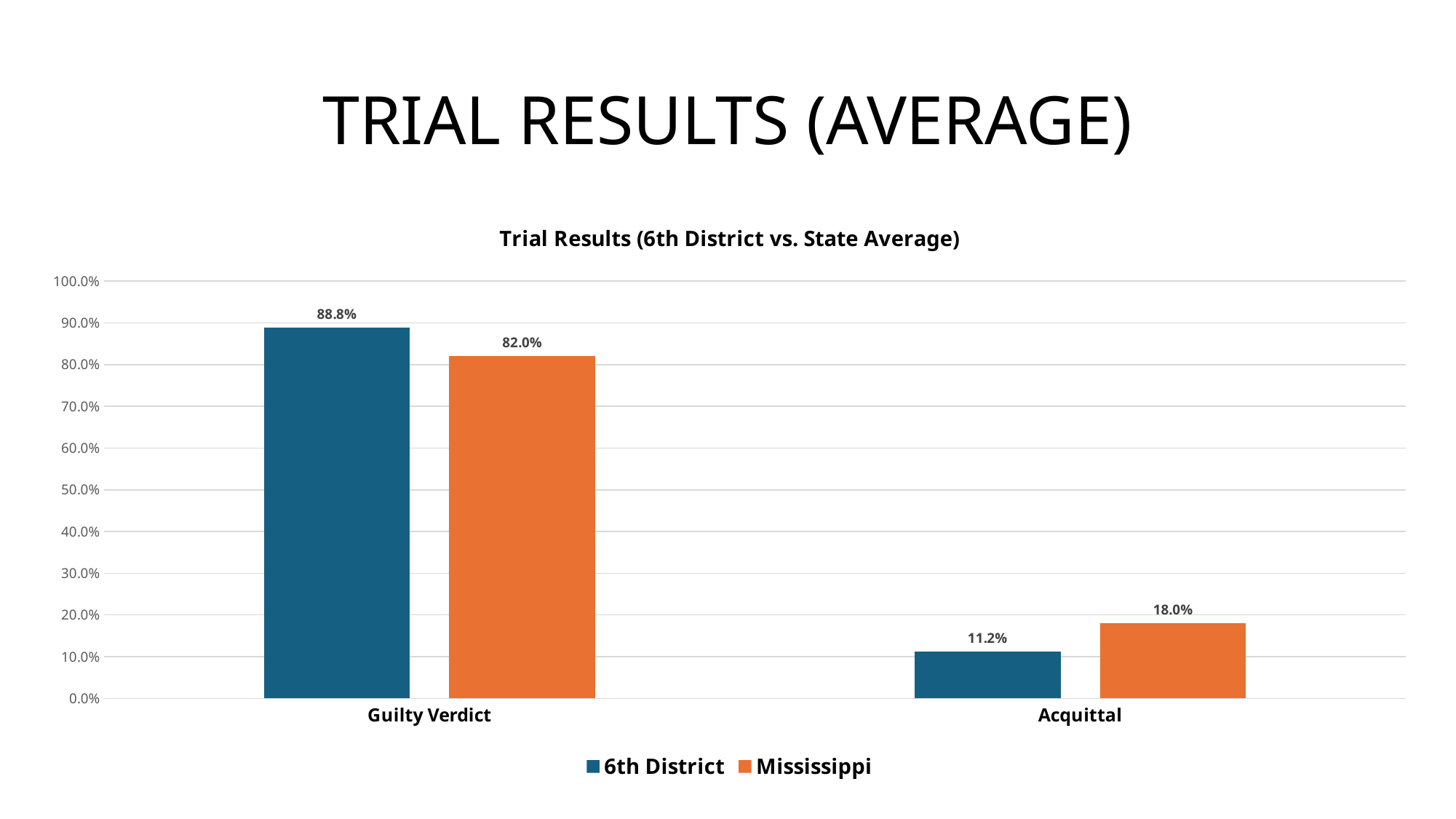
What is the Acquittal value for 6th District? 11.2% Which series has the higher Guilty Verdict value? 6th District What is the difference between the Mississippi and 6th District Acquittal values? 6.8% What is the Guilty Verdict value for 6th District? 88.8% What is the Guilty Verdict value for Mississippi? 82.0% What is the Acquittal value for Mississippi? 18.0% How many series does the legend list? 2 How many categories are shown on the x axis? 2 What kind of chart is shown? Bar chart Which series has the higher Acquittal value? Mississippi What is the difference between the 6th District and Mississippi Guilty Verdict values? 6.8% What is the title of the chart? Trial Results (6th District vs. State Average)